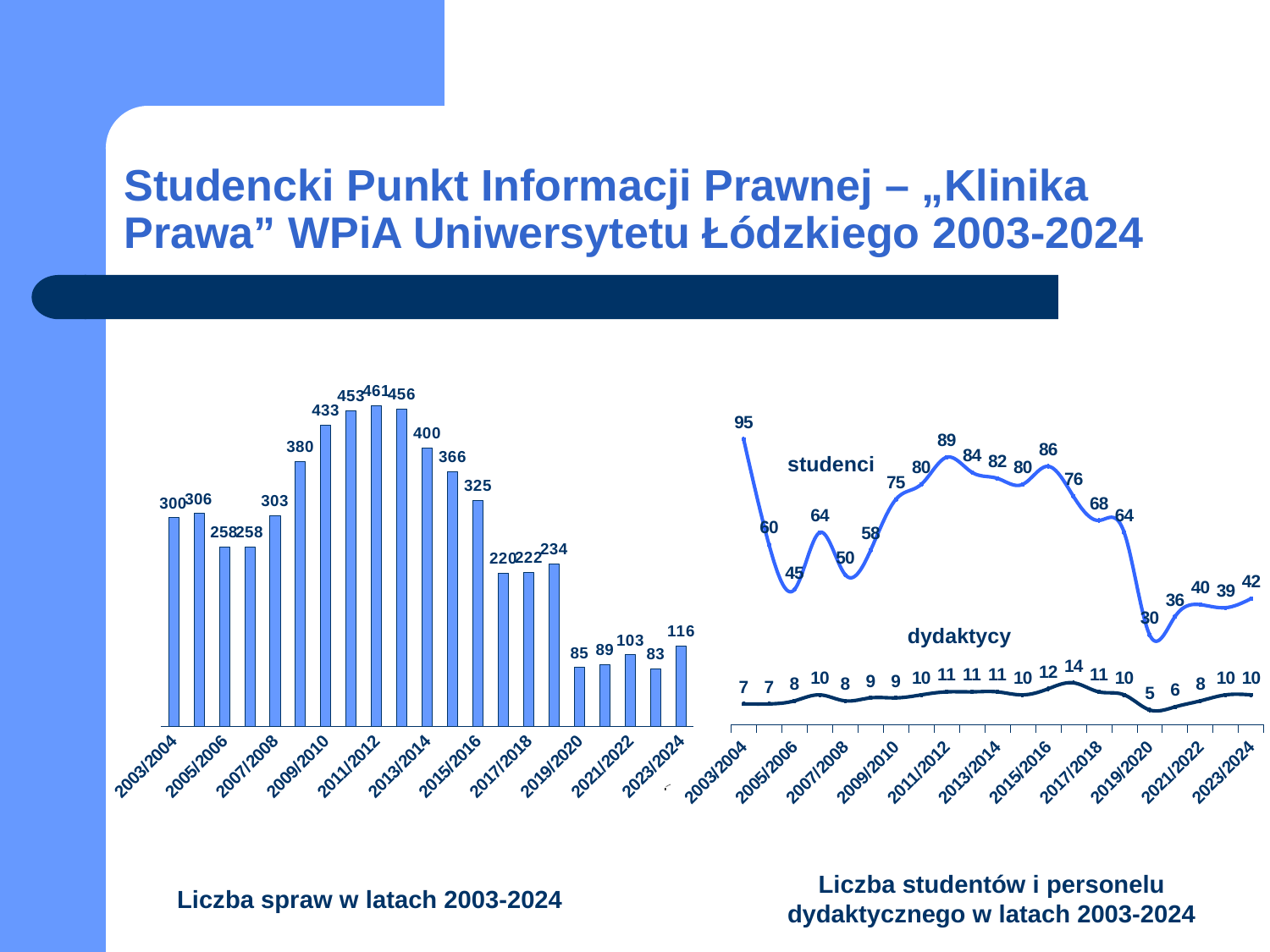
In the chart 'Liczba spraw w latach 2003-2024', which year has the highest value? 2011/2012 In the chart 'Liczba spraw w latach 2003-2024', what is the value for 2023/2024? 116 What type of chart is 'Liczba spraw w latach 2003-2024'? bar chart In the chart 'Liczba spraw w latach 2003-2024', which is larger: the value for 2013/2014 or the value for 2015/2016? 2013/2014 In the chart 'Liczba spraw w latach 2003-2024', what is the value for 2011/2012? 461 In the chart 'Liczba studentów i personelu dydaktycznego w latach 2003-2024', what is the difference between 'studenci' and 'dydaktycy' for 2023/2024? 32 In the chart 'Liczba studentów i personelu dydaktycznego w latach 2003-2024', what is the value of 'studenci' for 2003/2004? 95 How many series are shown in the chart 'Liczba studentów i personelu dydaktycznego w latach 2003-2024'? 2 In the chart 'Liczba spraw w latach 2003-2024', what is the difference between the values for 2009/2010 and 2019/2020? 348 In the chart 'Liczba studentów i personelu dydaktycznego w latach 2003-2024', what is the value of 'dydaktycy' for 2019/2020? 5 How many bars are in the chart 'Liczba spraw w latach 2003-2024'? 21 In the chart 'Liczba studentów i personelu dydaktycznego w latach 2003-2024', which year has the lowest value for 'studenci'? 2019/2020